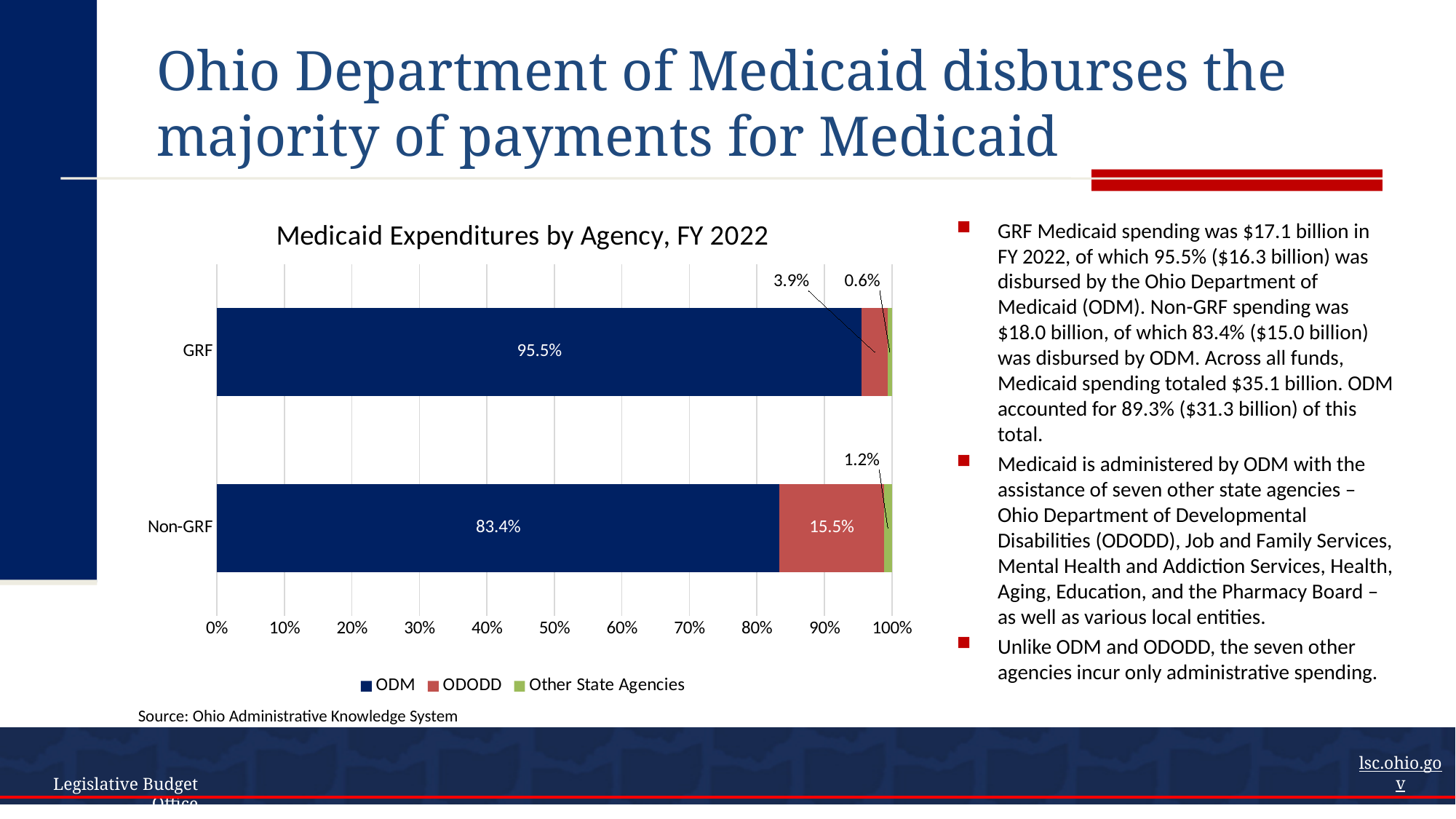
Which category has the higher ODM share, GRF or Non-GRF? GRF How many categories (bars) are shown in the chart? 2 What is the title of the chart? Medicaid Expenditures by Agency, FY 2022 What is the Other State Agencies share of GRF Medicaid expenditures? 0.6% What kind of chart is shown on the slide? Stacked bar chart How many series does the chart legend list? 3 What is the difference between the ODM share for GRF and the ODM share for Non-GRF? 12.1% What is the ODM share of GRF Medicaid expenditures? 95.5% What is the Other State Agencies share of Non-GRF Medicaid expenditures? 1.2% Which series is shown in dark blue in the chart? ODM What is the ODODD share of GRF Medicaid expenditures? 3.9% What is the ODODD share of Non-GRF Medicaid expenditures? 15.5%